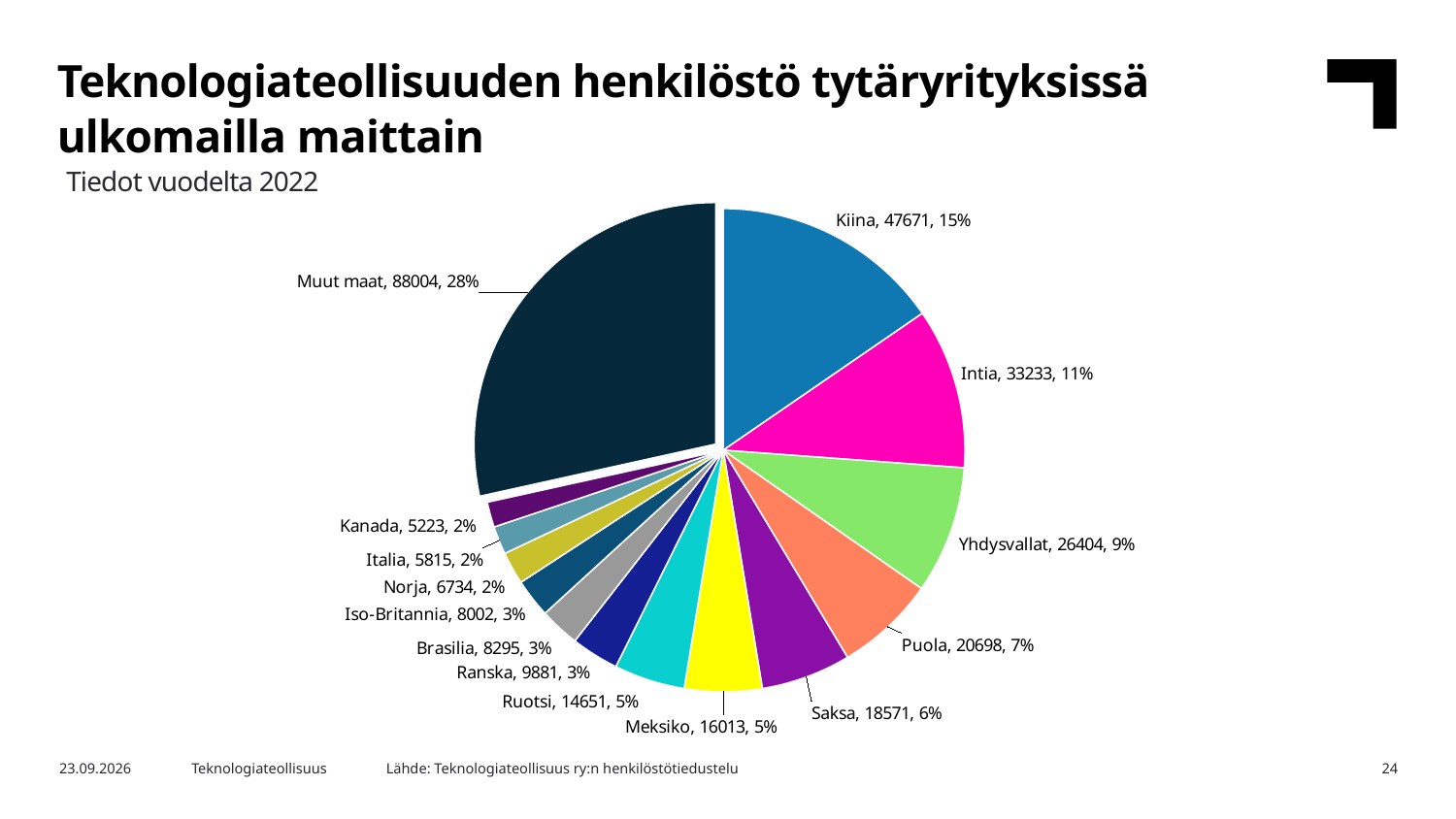
What is the value for Yhdysvallat? 26404 How many slices does the pie chart have? 14 What share of the pie does Muut maat represent? 28% What share of the pie does Intia represent? 11% What type of chart is shown on the slide? Pie chart What is the value for Meksiko? 16013 What year do the data on the slide refer to? 2022 Which is larger, the value for Puola or the value for Saksa? Puola What is the value for Kiina? 47671 Which slice has the smallest value? Kanada Which slice has the largest value? Muut maat What is the difference between the values for Kiina and Intia? 14438